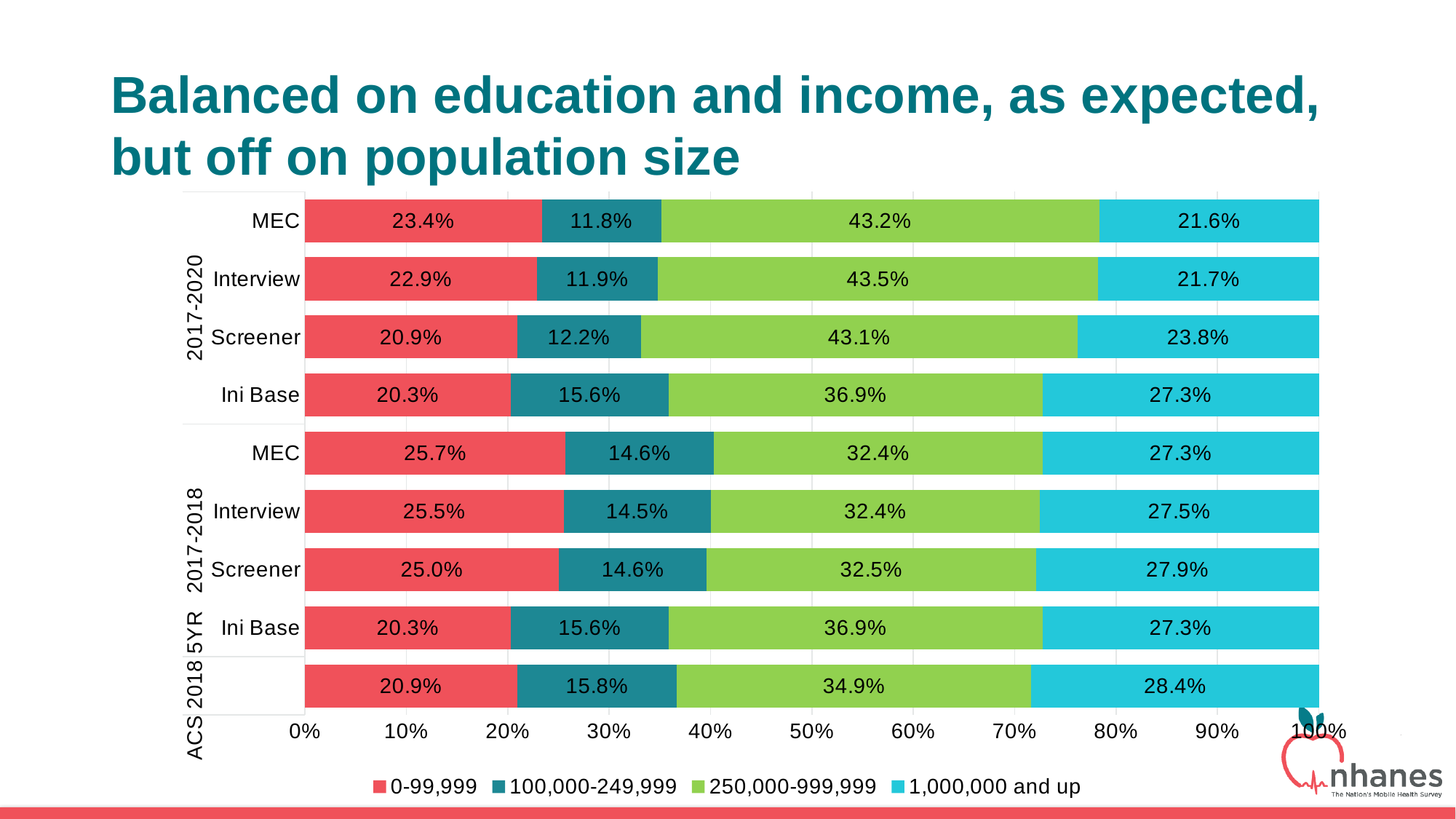
What is the value of the 250,000-999,999 segment for MEC in the 2017-2020 group? 43.2% What is the difference between the 1,000,000 and up segment for ACS 2018 5YR and for MEC in the 2017-2020 group? 6.8% Which legend entry is shown in red? 0-99,999 What kind of chart is shown on the slide? stacked bar chart What is the value of the 1,000,000 and up segment for Screener in the 2017-2018 group? 27.9% Which bar has the lowest value for the 100,000-249,999 segment? MEC (2017-2020) Which bar has the highest value for the 250,000-999,999 segment? Interview (2017-2020) What is the value of the 100,000-249,999 segment for Interview in the 2017-2020 group? 11.9% Which is larger: the 0-99,999 segment for MEC in 2017-2018 or for MEC in 2017-2020? MEC in 2017-2018 What is the value of the 0-99,999 segment for the ACS 2018 5YR bar? 20.9% How many series does the legend list? 4 How many bars are plotted on the chart? 9